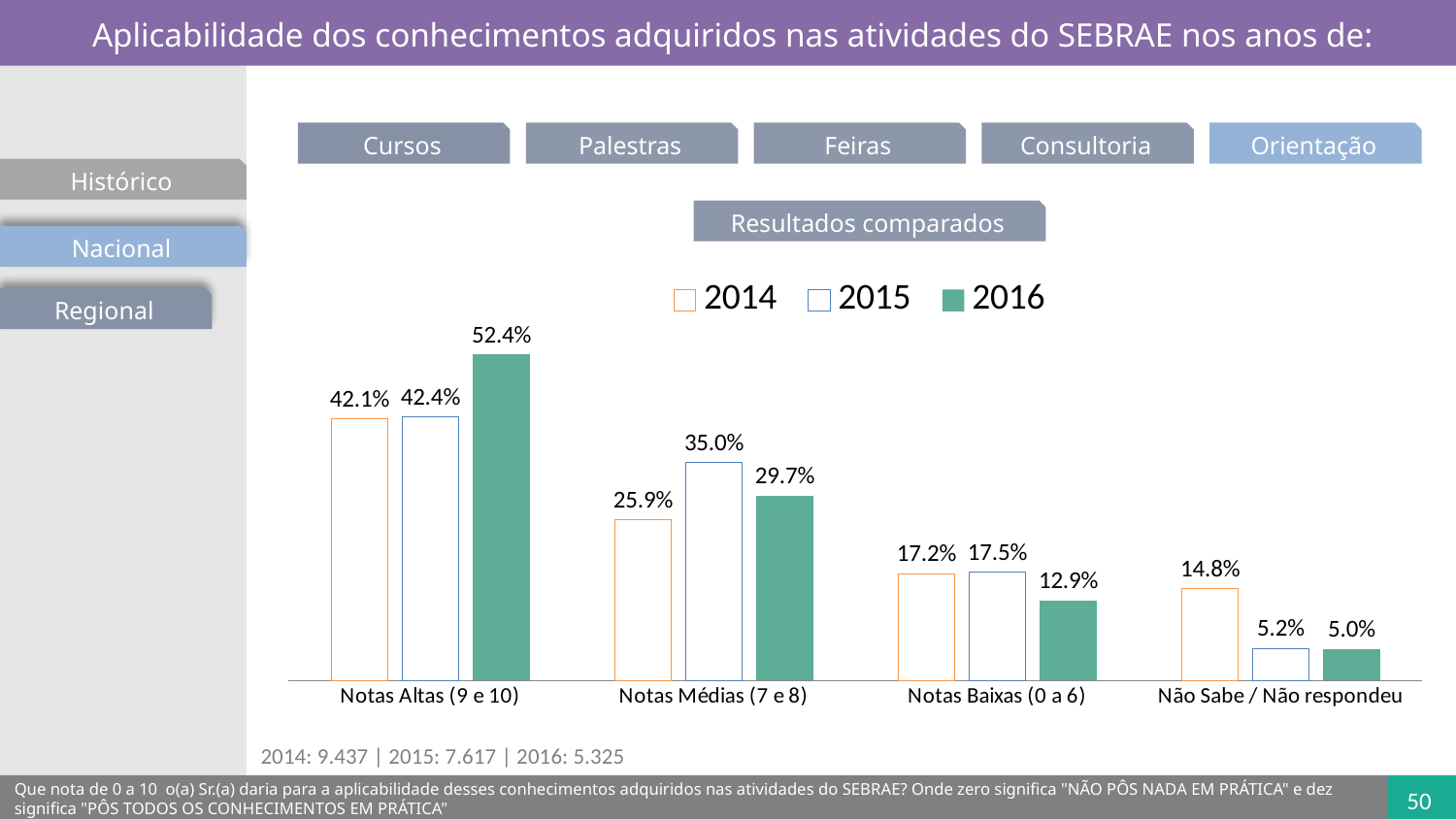
What kind of chart is shown on the slide? Bar chart In the 'Notas Médias (7 e 8)' category, which series has the larger value, 2015 or 2016? 2015 How many categories are shown on the x axis of the chart? 4 Which category has the highest value for the 2016 series? Notas Altas (9 e 10) How many series does the chart legend list? 3 What is the difference between the 2016 and 2014 values in the 'Notas Altas (9 e 10)' category? 10.3% What is the value for 2014 in the 'Notas Médias (7 e 8)' category? 25.9% What is the value for 2016 in the 'Notas Altas (9 e 10)' category? 52.4% What is the value for 2015 in the 'Notas Baixas (0 a 6)' category? 17.5% What is the value for 2014 in the 'Não Sabe / Não respondeu' category? 14.8% Which category has the lowest value for the 2015 series? Não Sabe / Não respondeu What is the title of the chart? Resultados comparados